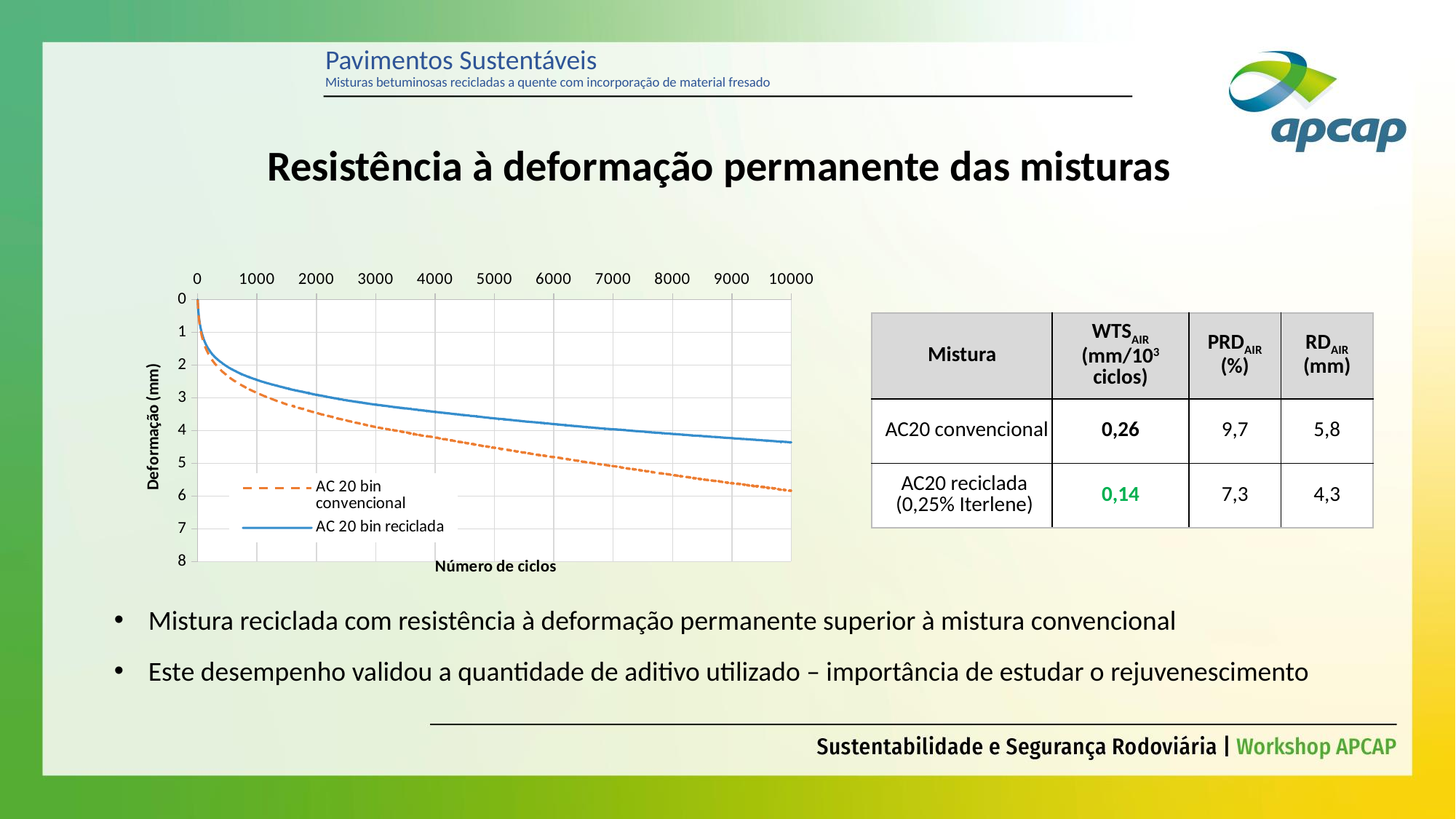
What kind of chart is shown on the slide? line chart What are the two series named in the chart legend? AC 20 bin convencional and AC 20 bin reciclada At 10000 cycles, which series shows the larger deformation, AC 20 bin convencional or AC 20 bin reciclada? AC 20 bin convencional Is the deformation of AC 20 bin reciclada at 5000 cycles greater or less than 4 mm? less Does the deformation of each series rise or fall as the number of cycles increases? rise Is the deformation of AC 20 bin reciclada at 10000 cycles greater or less than 5 mm? less How many series does the chart legend list? 2 What is the title of the chart's x axis? Número de ciclos Is the deformation of AC 20 bin convencional at 5000 cycles greater or less than 5 mm? less Which series has the lower deformation across the whole range of cycles? AC 20 bin reciclada